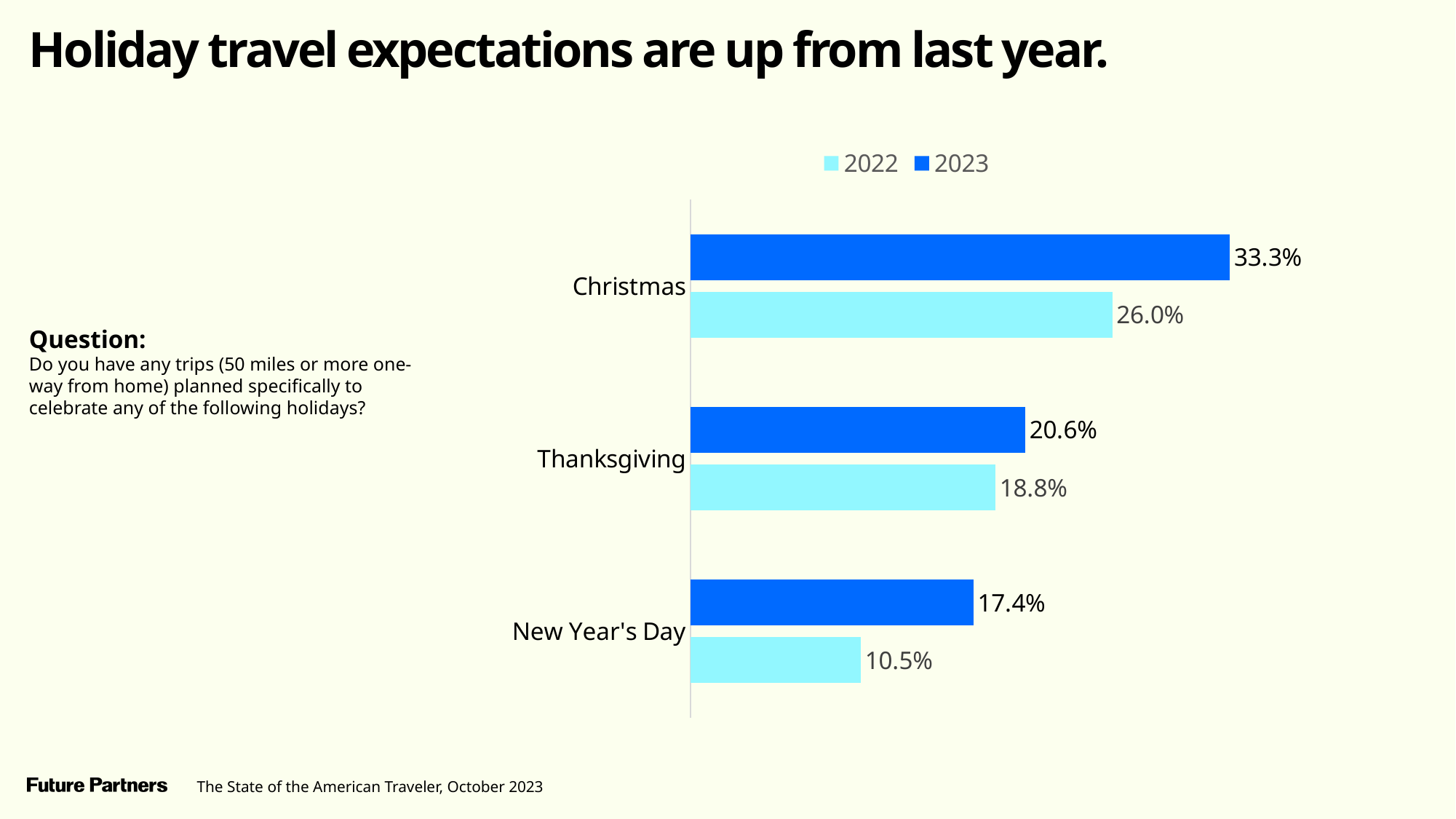
Which holiday has the highest 2023 value? Christmas What is the 2022 value for New Year's Day? 10.5% How many series does the legend list? 2 Which is larger, the 2023 value for Thanksgiving or the 2022 value for Christmas? 2022 value for Christmas What is the difference between the 2023 and 2022 values for New Year's Day? 6.9% How many holidays are shown on the chart? 3 What is the 2022 value for Thanksgiving? 18.8% Which holiday has the lowest 2022 value? New Year's Day What is the 2023 value for Christmas? 33.3% What is the difference between the 2023 and 2022 values for Christmas? 7.3% Which series is shown in dark blue? 2023 What kind of chart is shown on the slide? Bar chart